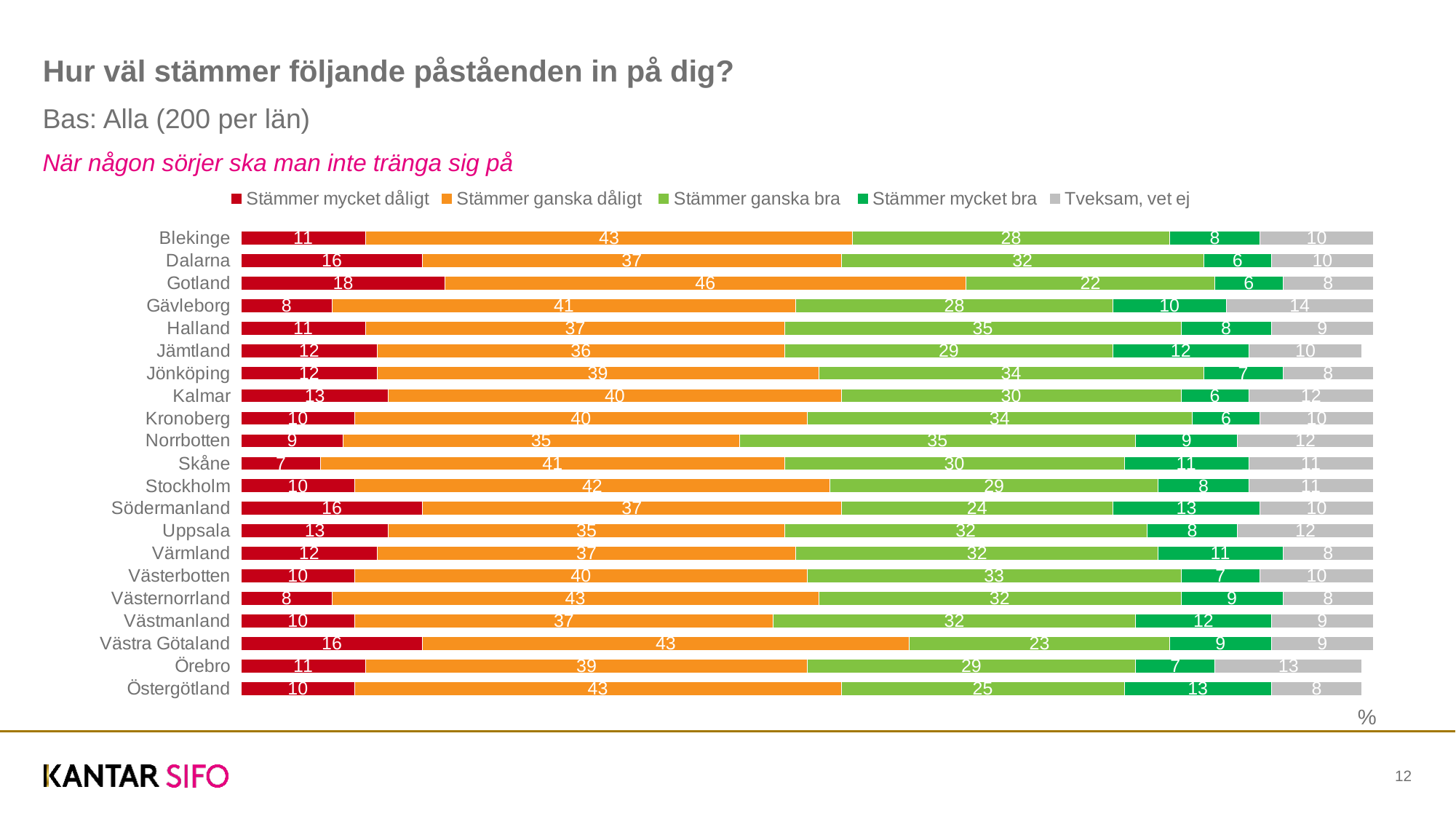
What kind of chart is shown on the slide? Stacked bar chart How many series does the legend list? 5 Which region has the lowest value for "Stämmer ganska bra"? Gotland Which region has the highest value for "Stämmer mycket dåligt"? Gotland What is the total of the stacked bar for Gotland? 100 What is the value for "Stämmer ganska dåligt" for Gotland? 46 What is the value for "Tveksam, vet ej" for Gävleborg? 14 How many regions are shown in the chart? 21 Which is larger: the "Stämmer ganska bra" value for Halland or for Västra Götaland? Halland What is the difference between the "Stämmer ganska dåligt" values for Gotland and Norrbotten? 11 What is the value for "Stämmer mycket bra" for Södermanland? 13 Which region has the lowest value for "Stämmer mycket dåligt"? Skåne